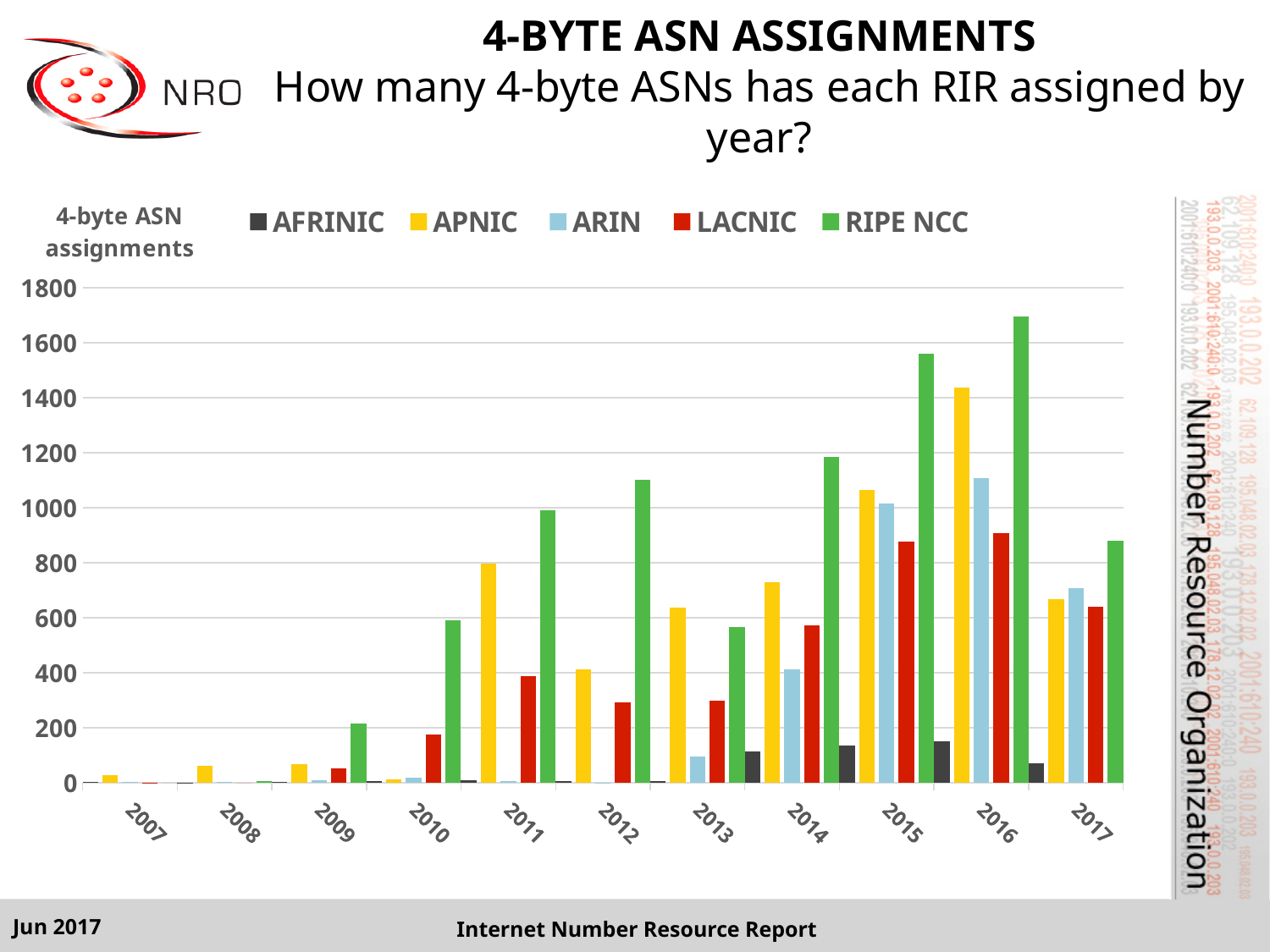
In 2014, which assigned more 4-byte ASNs, RIPE NCC or APNIC? RIPE NCC Is the value for RIPE NCC in 2016 greater or less than 1600? greater How many series does the legend list? 5 Is the value for ARIN in 2013 greater or less than 200? less Which RIR assigned the most 4-byte ASNs in 2013? APNIC In which year did RIPE NCC assign the most 4-byte ASNs? 2016 In which year did APNIC assign the most 4-byte ASNs? 2016 What kind of chart is shown on the slide? bar chart Is the value for LACNIC in 2015 greater or less than 800? greater Which colour represents RIPE NCC in the legend? green How many years are shown along the x axis? 11